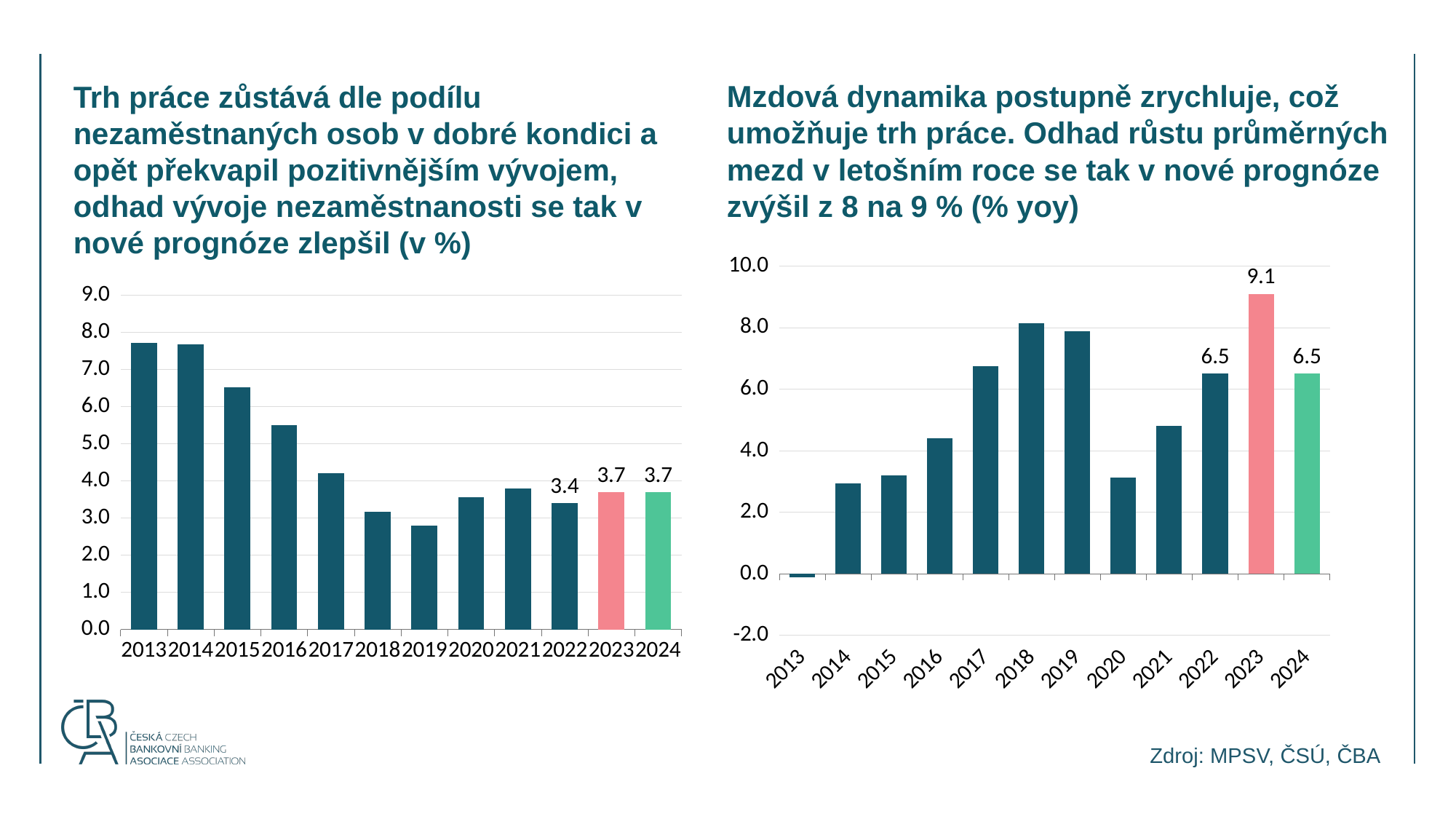
On the right chart, what is the value for 2023? 9.1 On the left chart, what is the value for 2023? 3.7 On the right chart, what is the value for 2024? 6.5 How many years are shown on the right chart? 12 On the left chart, is the value for 2015 greater or less than 6.0? greater What type of chart is the left chart? bar chart On the left chart, which is larger, the value for 2013 or the value for 2017? 2013 On the left chart, which year has the lowest value? 2019 On the right chart, is the value for 2020 greater or less than 4.0? less On the left chart, what is the value for 2022? 3.4 On the right chart, which year has the highest value? 2023 On the right chart, what is the difference between the values for 2023 and 2022? 2.6